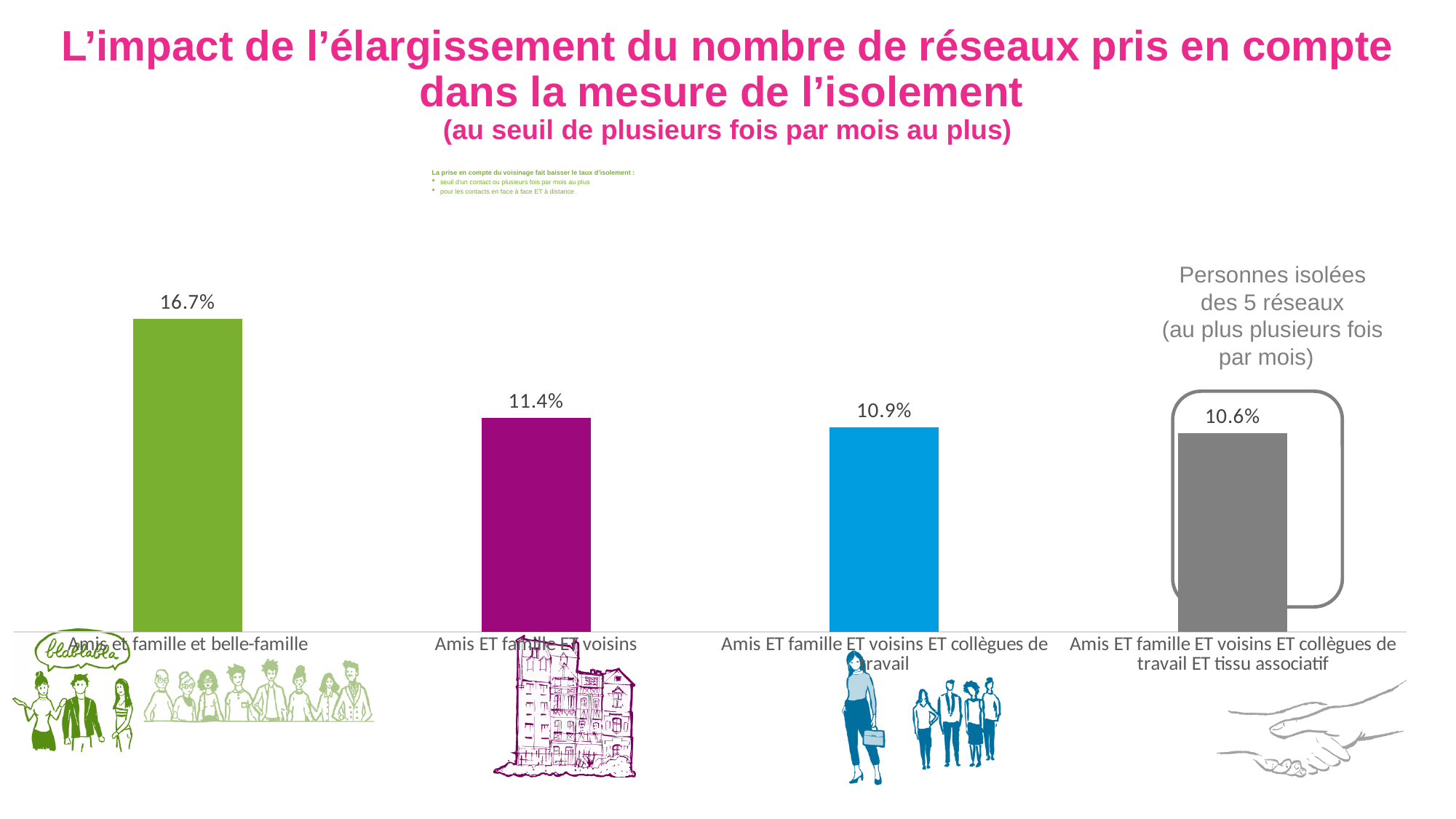
Which category has the lowest value? Amis ET famille ET voisins ET collègues de travail ET tissu associatif What is the value for "Amis ET famille ET voisins ET collègues de travail"? 10.9% Which is larger: the value for "Amis ET famille ET voisins" or the value for "Amis ET famille ET voisins ET collègues de travail"? Amis ET famille ET voisins What is the value for "Amis ET famille ET voisins ET collègues de travail ET tissu associatif"? 10.6% How many categories are shown in the chart? 4 What is the value for "Amis et famille et belle-famille"? 16.7% What is the difference between the values for "Amis et famille et belle-famille" and "Amis ET famille ET voisins"? 5.3% Which category has the highest value? Amis et famille et belle-famille What is the value for "Amis ET famille ET voisins"? 11.4% Do the values rise or fall from left to right across the categories? Fall What is the difference between the values for "Amis ET famille ET voisins ET collègues de travail" and "Amis ET famille ET voisins ET collègues de travail ET tissu associatif"? 0.3% What kind of chart is shown on the slide? Bar chart